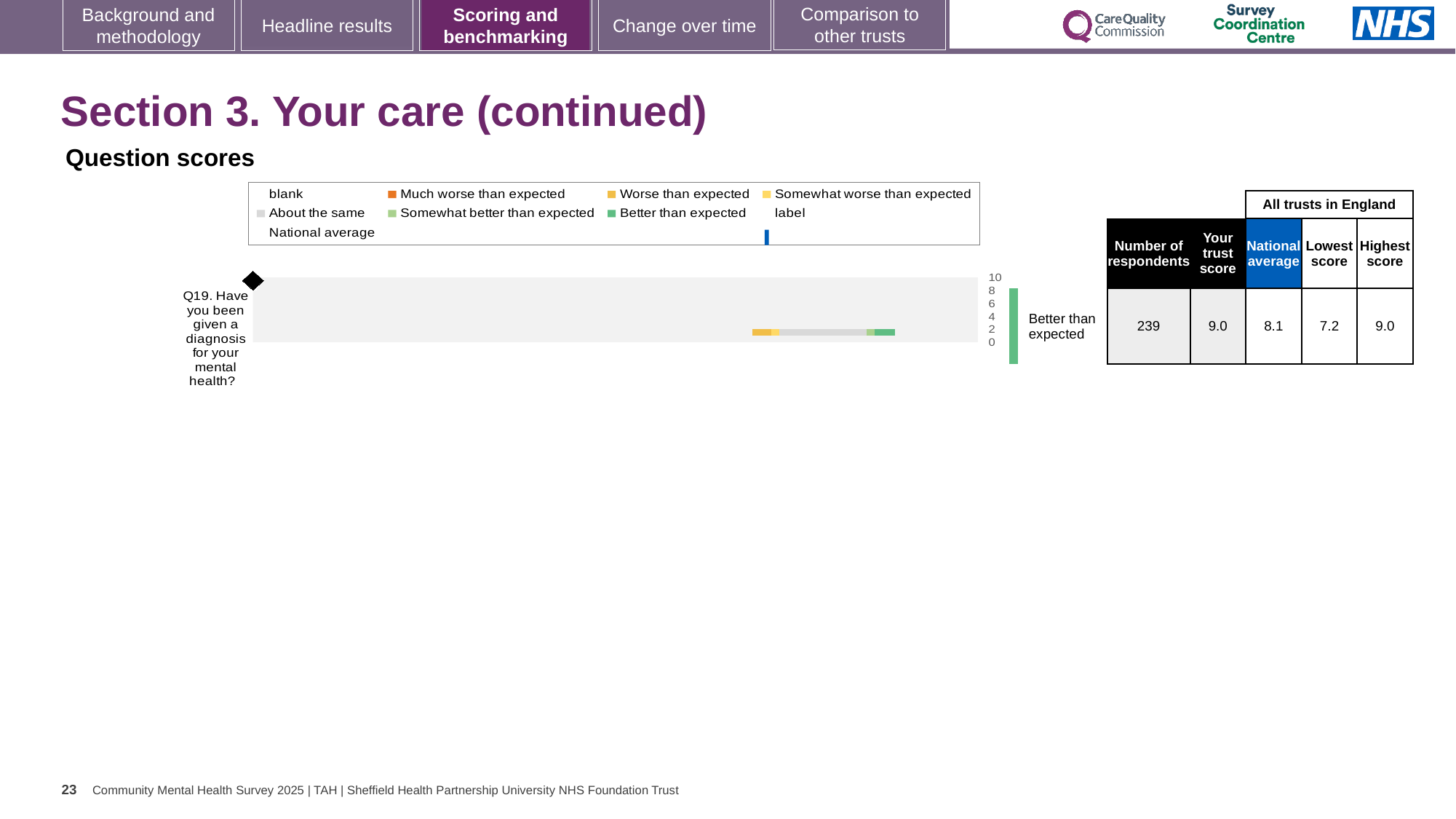
What is the trust score for Q19? 9.0 Which is larger for Q19, the trust score or the national average? the trust score What is the national average score for Q19? 8.1 How many questions are plotted in the question scores chart? 1 How many respondents answered Q19? 239 What does the blue marker in the chart legend represent? National average What is the lowest score among all trusts in England for Q19? 7.2 What benchmark category is the trust's Q19 score placed in? Better than expected Which question is shown in the question scores chart? Q19. Have you been given a diagnosis for your mental health? What kind of chart is used to show the question scores on this slide? bar chart By how much does the trust score for Q19 exceed the national average? 0.9 What is the highest score among all trusts in England for Q19? 9.0